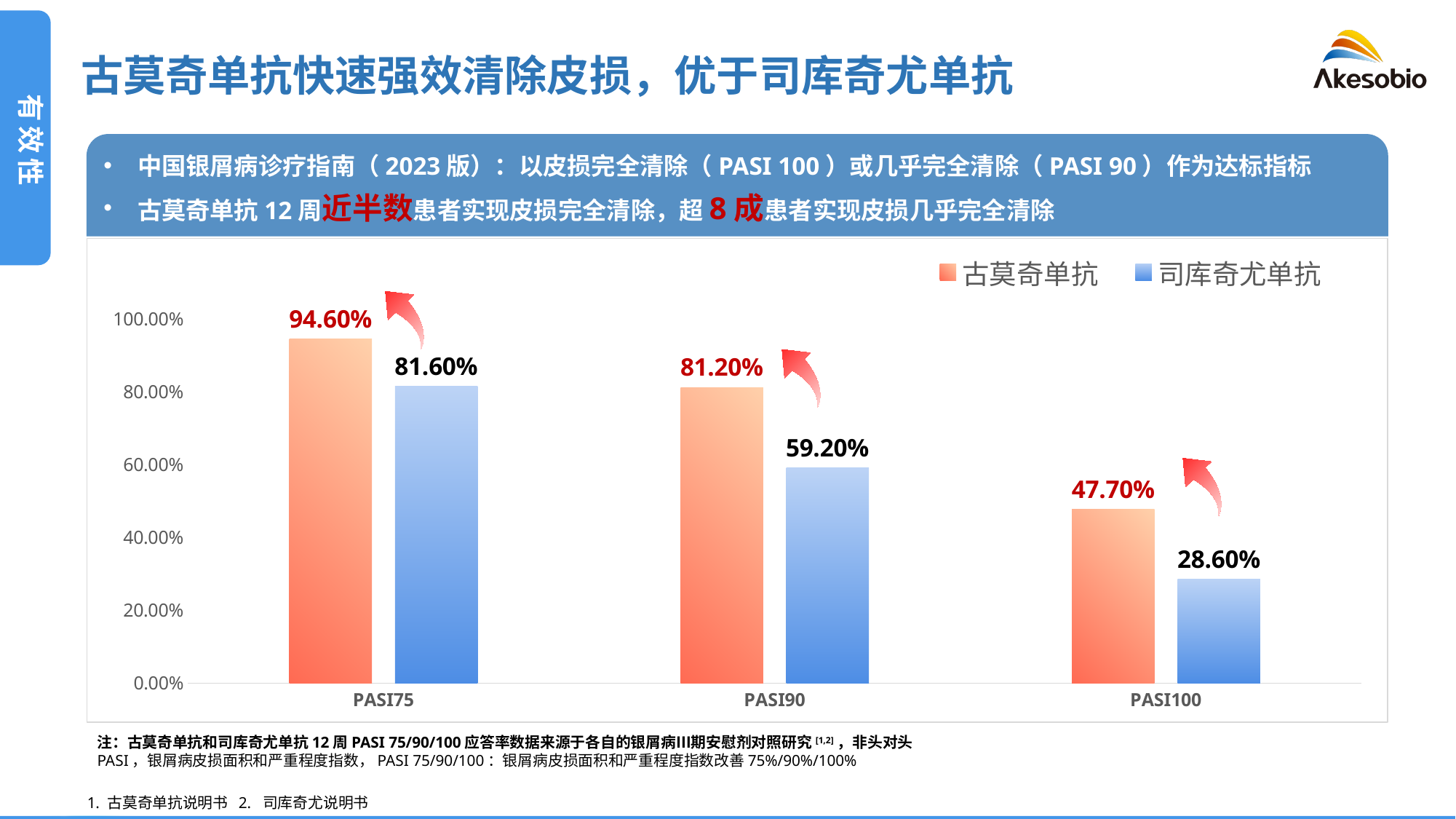
Which is larger at PASI75: 古莫奇单抗 or 司库奇尤单抗? 古莫奇单抗 Do the values for 古莫奇单抗 rise or fall from PASI75 to PASI100? fall What kind of chart is shown on the slide? bar chart How many categories are shown on the x axis? 3 What is the difference between 古莫奇单抗 and 司库奇尤单抗 at PASI90? 22.00% How many series does the legend list? 2 What is the value for 古莫奇单抗 at PASI100? 47.70% Which category has the highest value for 司库奇尤单抗? PASI75 What is the value for 司库奇尤单抗 at PASI100? 28.60% What is the value for 古莫奇单抗 at PASI75? 94.60% What is the value for 司库奇尤单抗 at PASI90? 59.20% Which category has the lowest value for 古莫奇单抗? PASI100